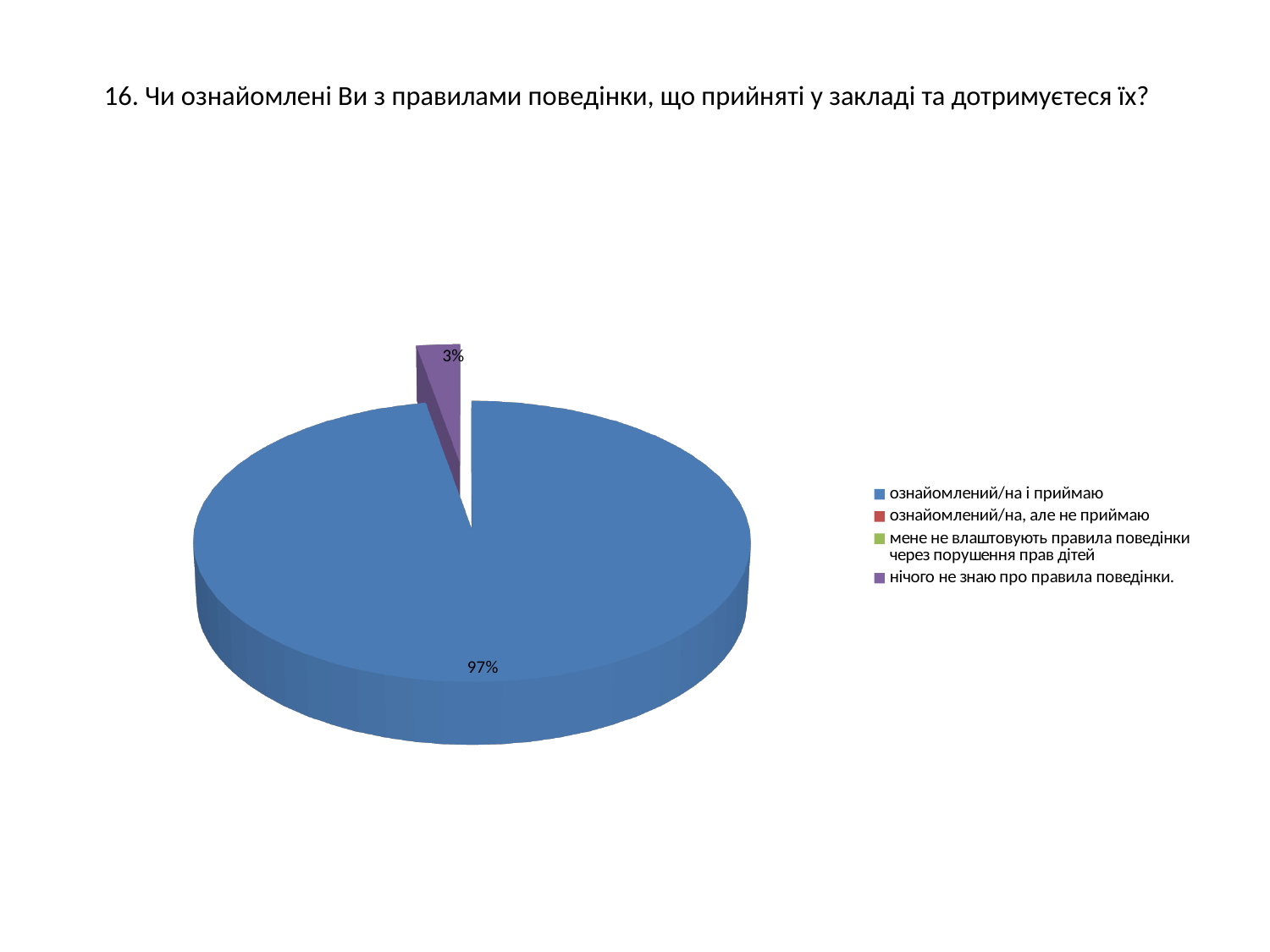
What share of the pie does the slice "нічого не знаю про правила поведінки." take? 3% What is the title of the chart? 16. Чи ознайомлені Ви з правилами поведінки, що прийняті у закладі та дотримуєтеся їх? Which of the two labelled slices is smaller, "ознайомлений/на і приймаю" or "нічого не знаю про правила поведінки."? нічого не знаю про правила поведінки. Which category has the largest slice of the pie? ознайомлений/на і приймаю What colour is the slice labelled 97%? blue Is the share for "ознайомлений/на і приймаю" greater or less than 50%? greater What is the difference in percentage points between the 97% slice and the 3% slice? 94 How many entries does the legend list? 4 What kind of chart is shown on the slide? pie chart What share of the pie does the slice "ознайомлений/на і приймаю" take? 97% How many slices with data labels are visible in the pie? 2